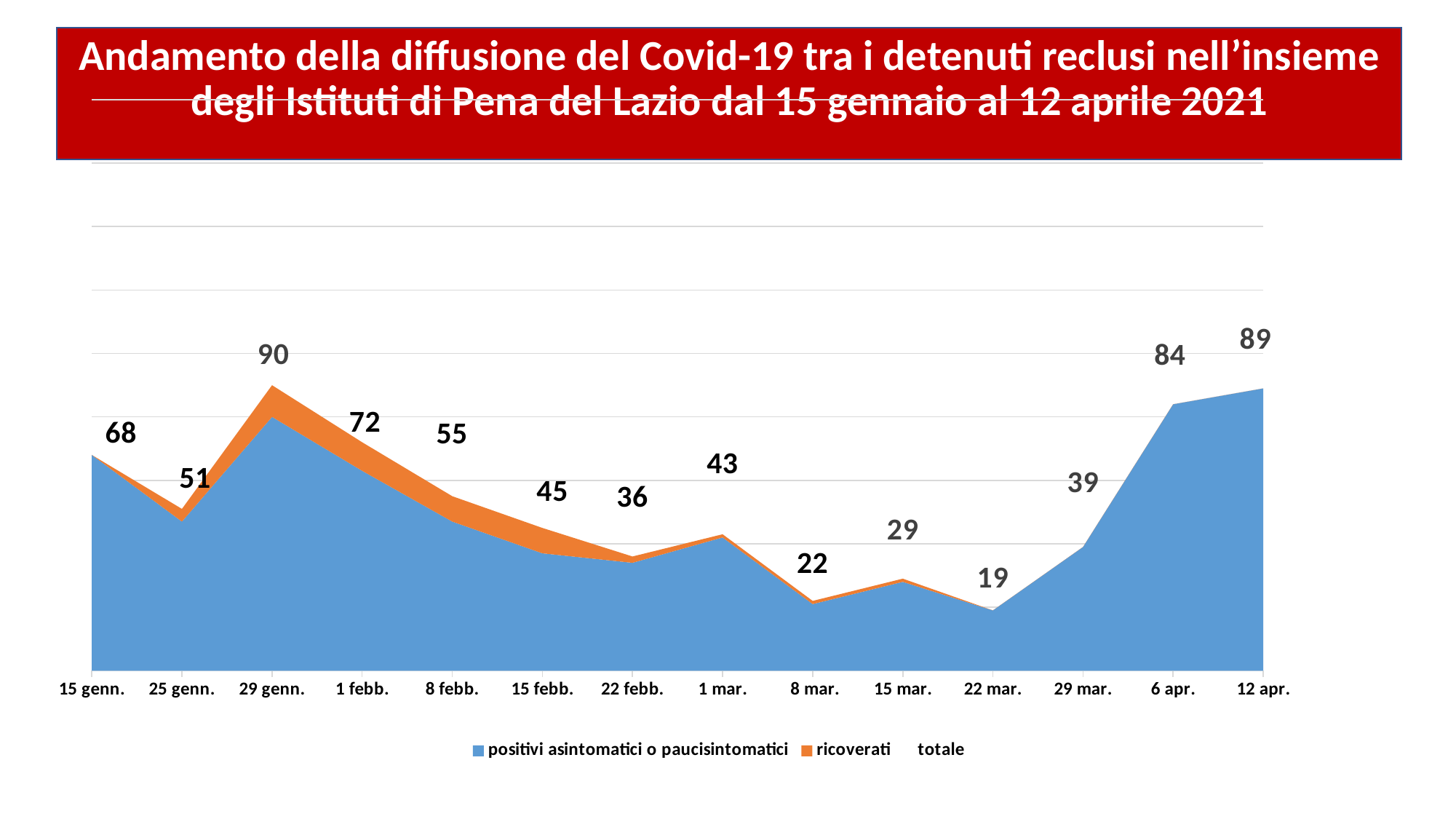
How many dates are shown on the x axis? 14 What kind of chart is shown on the slide? Area chart On which date is the total value lowest? 22 mar. On which date is the total value highest? 29 genn. What is the difference between the total values for 29 genn. and 25 genn.? 39 How many series does the legend list? 3 What is the total value shown for 1 mar.? 43 What is the difference between the total values for 12 apr. and 6 apr.? 5 What is the total value shown for 22 mar.? 19 Which date has a larger total value, 15 febb. or 22 febb.? 15 febb. What is the total (totale) value shown for 29 genn.? 90 What is the total value shown for 12 apr.? 89